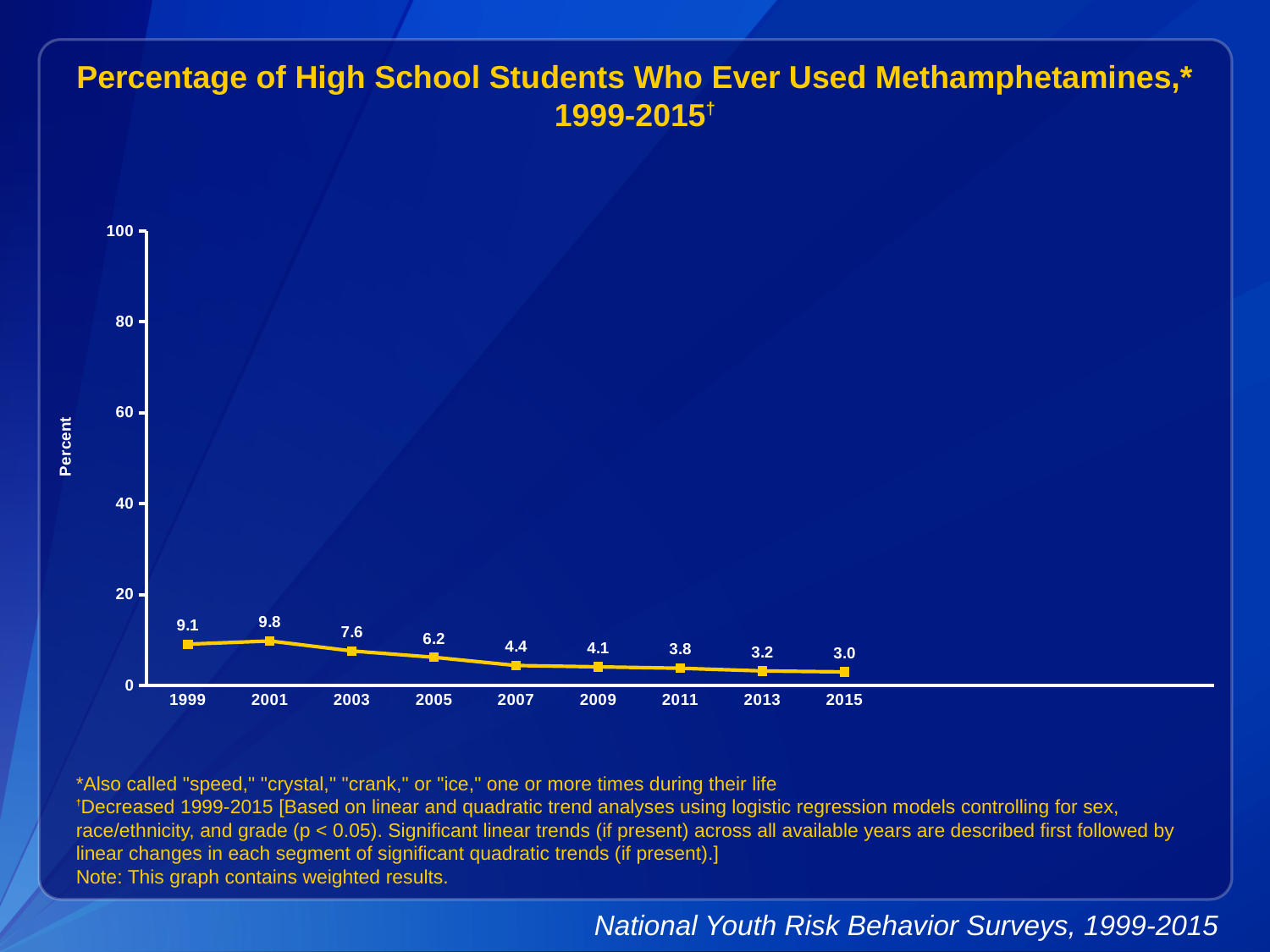
Which year has the highest percentage? 2001 What is the value plotted for 2007? 4.4 Which year has a larger value, 2003 or 2009? 2003 How many years are plotted on the x axis? 9 Is the value for 2001 greater or less than 20? less Do the values generally rise or fall from 1999 to 2015? fall What is the difference between the 2001 value and the 2015 value? 6.8 Which year has the lowest percentage? 2015 What is the label on the y axis? Percent What is the value plotted for 2015? 3.0 What percentage of high school students had ever used methamphetamines in 1999? 9.1 What kind of chart is shown on the slide? line chart